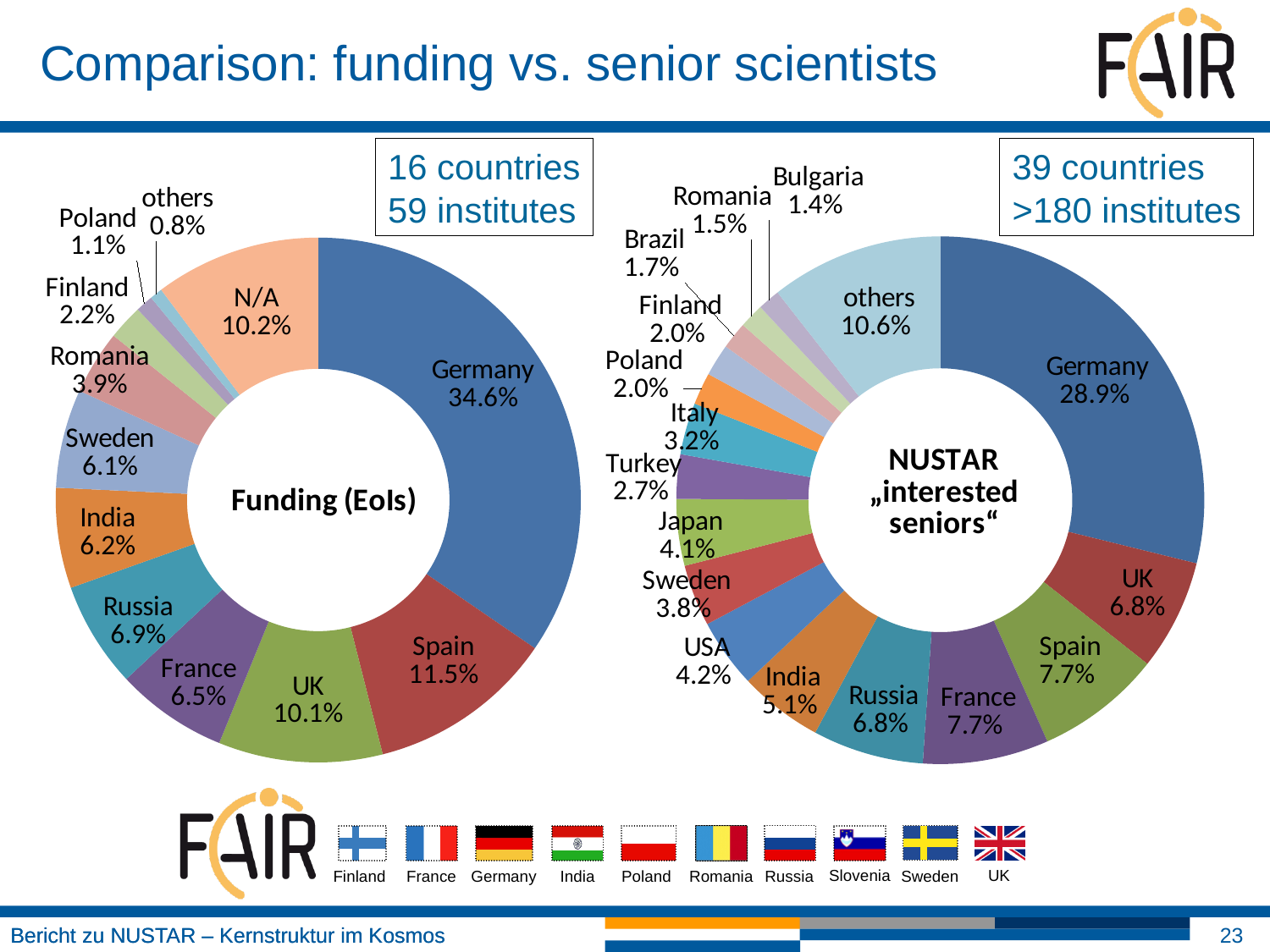
In the Funding (EoIs) chart, what is the difference between Germany's share and Spain's share? 23.1% In the Funding (EoIs) chart, which country has the largest share? Germany In the Funding (EoIs) chart, what share does Germany have? 34.6% In the NUSTAR "interested seniors" chart, what share does Japan have? 4.1% In the Funding (EoIs) chart, what share does Spain have? 11.5% In the NUSTAR "interested seniors" chart, which is larger: the share for Spain or the share for UK? Spain In the NUSTAR "interested seniors" chart, what share does Germany have? 28.9% In the Funding (EoIs) chart, which labelled slice has the smallest share? others In the NUSTAR "interested seniors" chart, which labelled country has the smallest share? Bulgaria How many slices does the Funding (EoIs) chart have? 12 How many slices does the NUSTAR "interested seniors" chart have? 17 What kind of chart is the Funding (EoIs) chart on the left? Pie chart (donut)